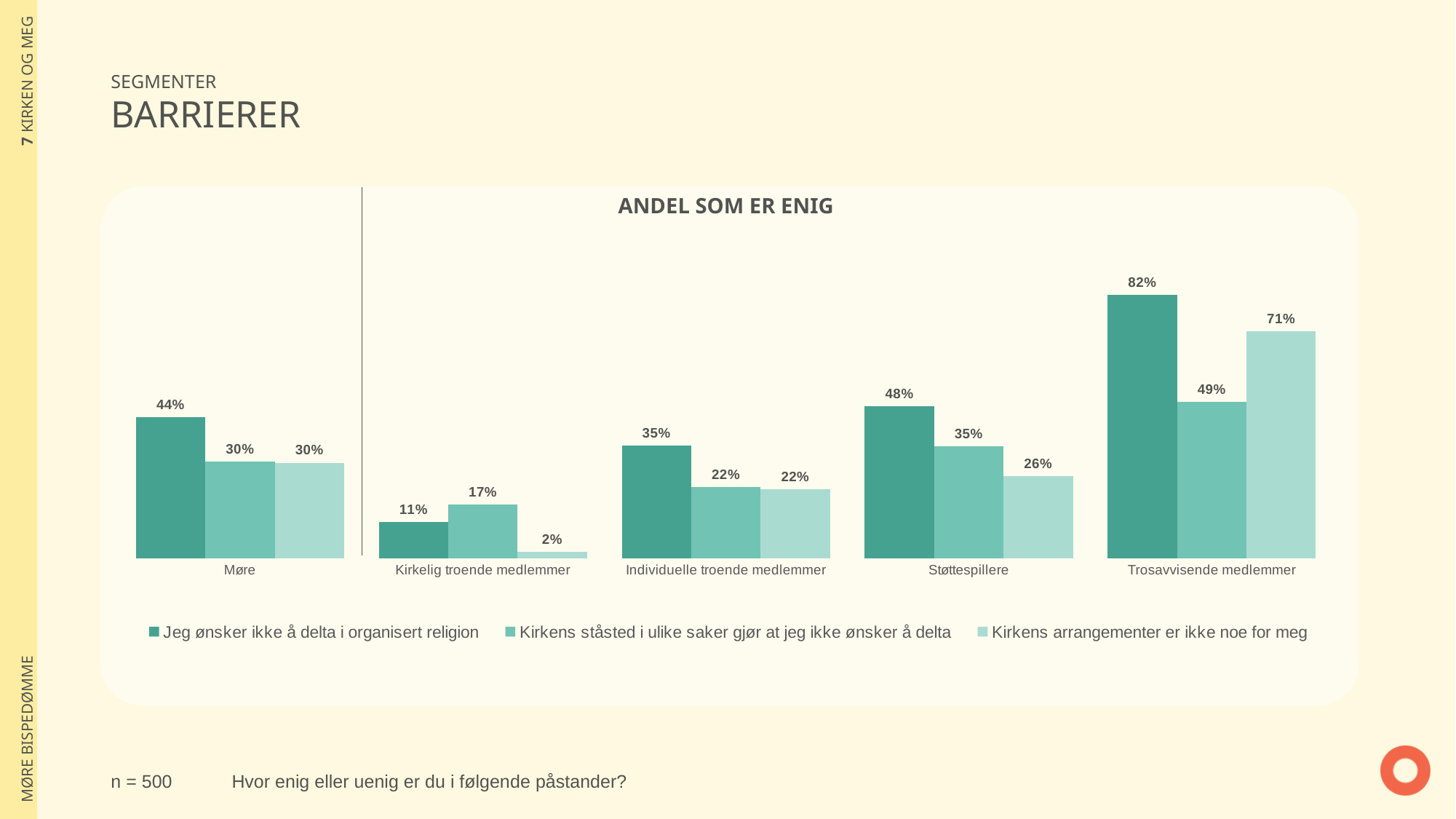
Which category has the lowest value for 'Kirkens arrangementer er ikke noe for meg'? Kirkelig troende medlemmer What is the value for 'Kirkens ståsted i ulike saker gjør at jeg ikke ønsker å delta' in the Støttespillere category? 35% What is the title of the chart? ANDEL SOM ER ENIG How many series does the legend list? 3 Which category has the highest value for 'Jeg ønsker ikke å delta i organisert religion'? Trosavvisende medlemmer What kind of chart is shown on the slide? Bar chart What is the value for 'Kirkens arrangementer er ikke noe for meg' in the Kirkelig troende medlemmer category? 2% How many categories are shown on the x axis? 5 What is the difference between the 'Jeg ønsker ikke å delta i organisert religion' values for Trosavvisende medlemmer and Møre? 38% What is the value for 'Jeg ønsker ikke å delta i organisert religion' in the Trosavvisende medlemmer category? 82% Which is larger: 'Kirkens ståsted i ulike saker gjør at jeg ikke ønsker å delta' for Møre or for Individuelle troende medlemmer? Møre What is the difference between the 'Kirkens arrangementer er ikke noe for meg' value and the 'Kirkens ståsted i ulike saker gjør at jeg ikke ønsker å delta' value for Trosavvisende medlemmer? 22%